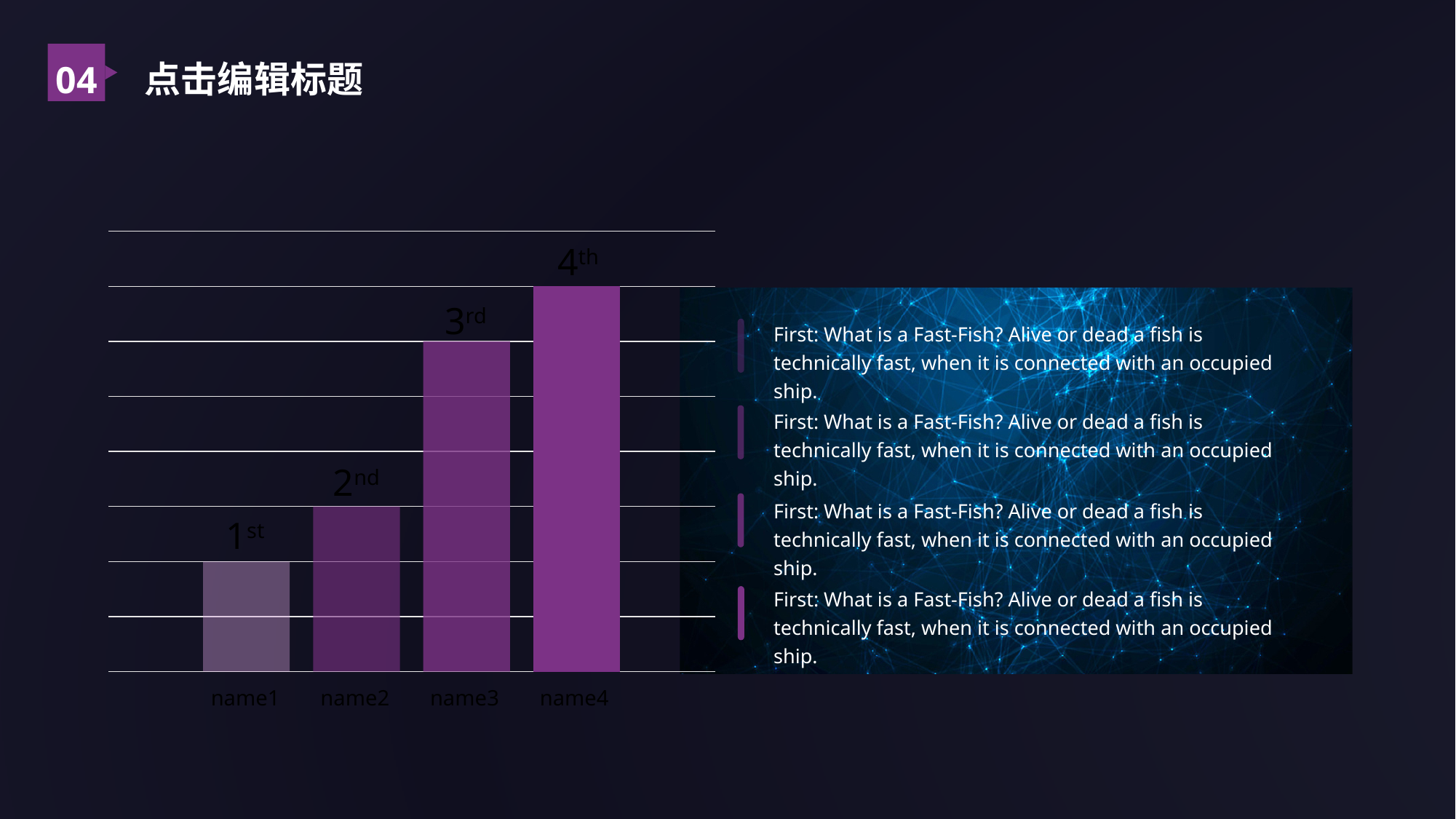
Which bar is taller, name1 or name4? name4 What colour are the bars in the chart? purple Which category is labelled "2nd" above its bar? name2 Which category has the tallest bar? name4 Which bar is taller, name2 or name3? name3 What label is printed above the bar for name3? 3rd What kind of chart is shown on the slide? bar chart What label is printed above the bar for name1? 1st Do the bar heights rise or fall from name1 to name4? rise What is the label of the last category on the x axis? name4 How many bars does the chart have? 4 Which category has the shortest bar? name1